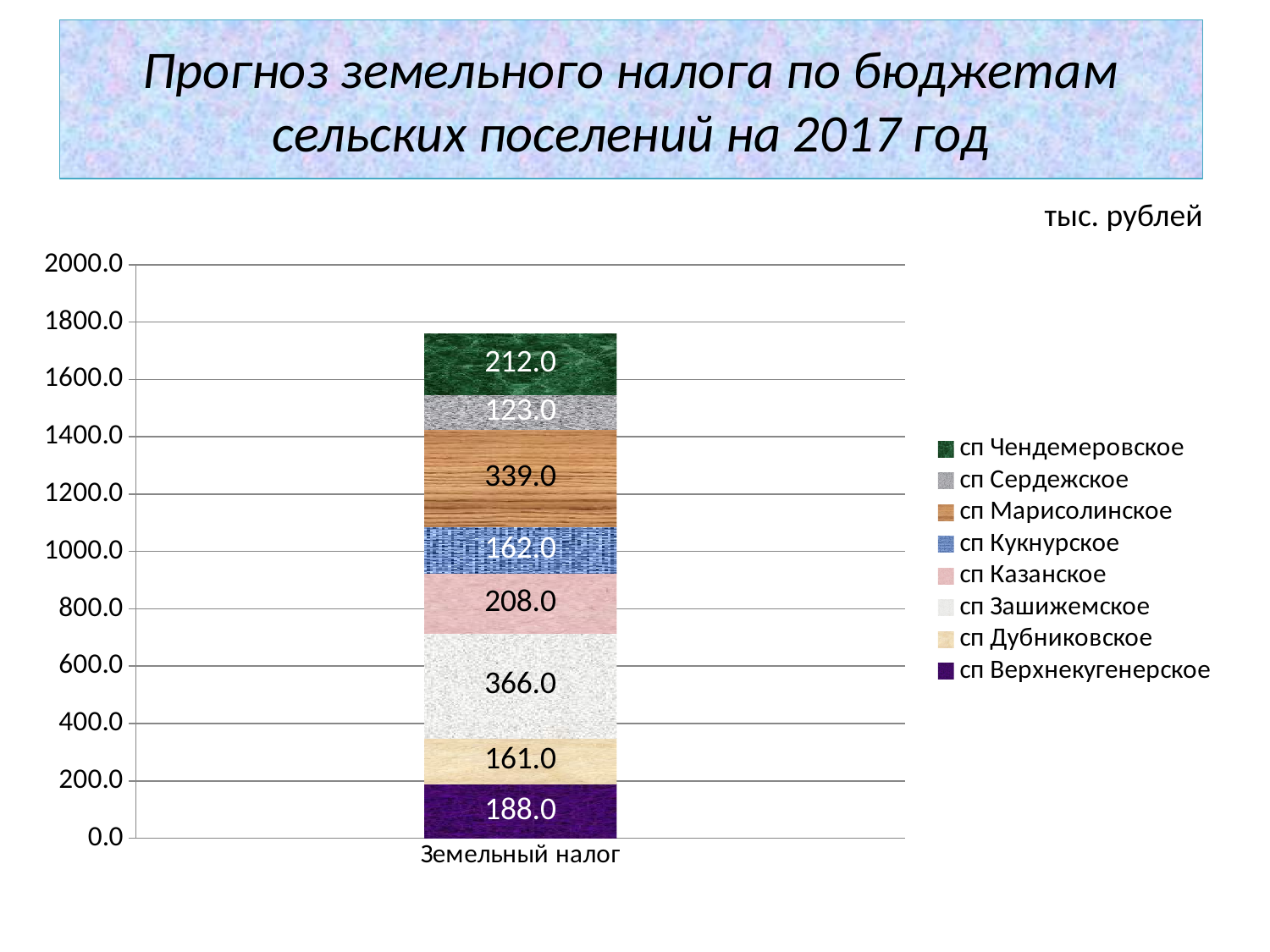
Which settlement has the highest land tax forecast? сп Зашижемское What is the value for сп Марисолинское? 339.0 What is the total of the stacked bar for Земельный налог? 1759.0 What unit is stated above the chart? тыс. рублей Which is larger, the value for сп Казанское or сп Чендемеровское? сп Чендемеровское What is the value for сп Зашижемское? 366.0 Which settlement has the lowest land tax forecast? сп Сердежское What is the difference between the values for сп Зашижемское and сп Марисолинское? 27.0 How many series does the legend list? 8 What type of chart is shown on the slide? Stacked bar chart What is the value for сп Сердежское? 123.0 What is the value for сп Верхнекугенерское? 188.0